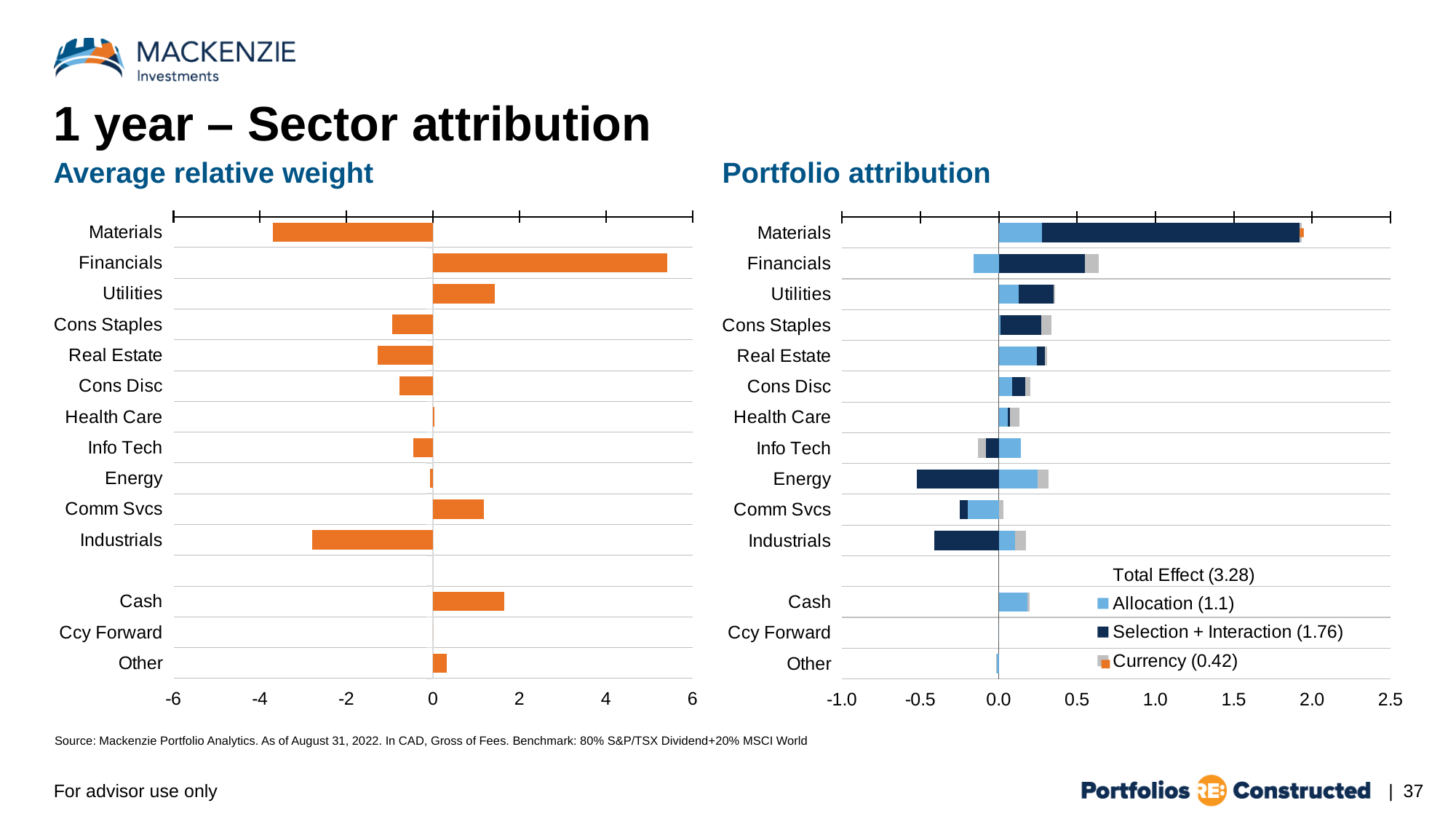
In the 'Average relative weight' chart, is the value for Industrials greater or less than -2? less How many series does the legend of the 'Portfolio attribution' chart list? 4 In the 'Portfolio attribution' chart, what value is shown next to 'Selection + Interaction' in the legend? 1.76 In the 'Portfolio attribution' chart, is the Selection + Interaction value for Energy greater or less than 0.0? less In the 'Average relative weight' chart, which is larger, the value for Utilities or the value for Comm Svcs? Utilities In the 'Average relative weight' chart, is the value for Financials greater or less than 4? greater In the 'Average relative weight' chart, which category has the lowest value? Materials In the 'Portfolio attribution' chart, what Total Effect value is shown in the legend? 3.28 How many categories are labelled on the 'Average relative weight' chart? 14 What kind of chart is the 'Average relative weight' chart? bar chart In the 'Average relative weight' chart, which category has the highest value? Financials